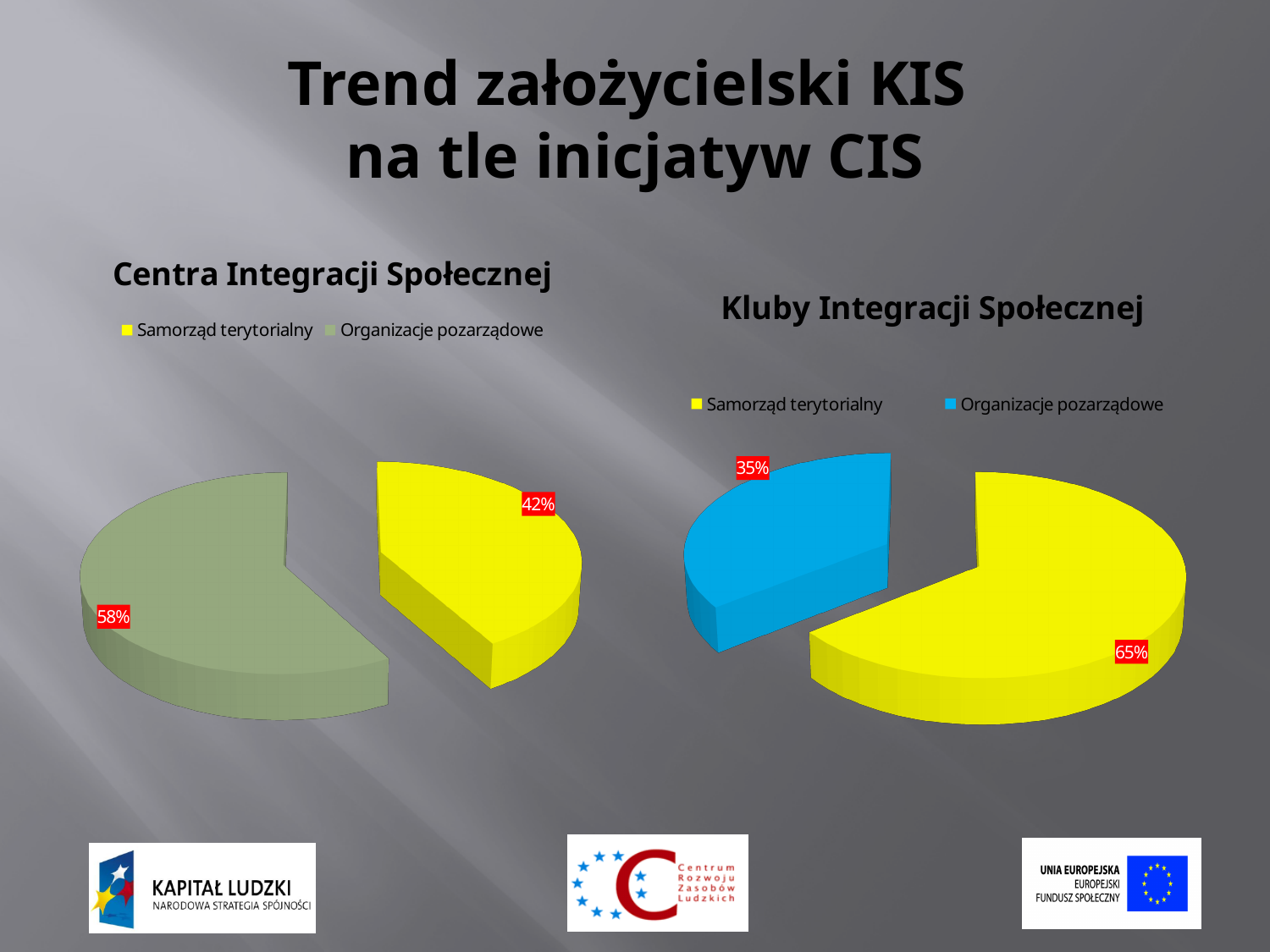
In the 'Centra Integracji Społecznej' chart, which category has the largest slice? Organizacje pozarządowe In the 'Kluby Integracji Społecznej' chart, what share does Samorząd terytorialny have? 65% What type of chart is the 'Kluby Integracji Społecznej' chart? Pie chart In the 'Kluby Integracji Społecznej' chart, which category has the smallest slice? Organizacje pozarządowe Which is larger: the Samorząd terytorialny share in the 'Centra Integracji Społecznej' chart or in the 'Kluby Integracji Społecznej' chart? Kluby Integracji Społecznej In the 'Centra Integracji Społecznej' chart, what share does Organizacje pozarządowe have? 58% In the 'Centra Integracji Społecznej' chart, what share does Samorząd terytorialny have? 42% In the 'Kluby Integracji Społecznej' chart, what share does Organizacje pozarządowe have? 35% How many slices does the 'Centra Integracji Społecznej' pie chart have? 2 In the 'Centra Integracji Społecznej' chart, what is the difference in percentage points between Organizacje pozarządowe and Samorząd terytorialny? 16 In the 'Kluby Integracji Społecznej' chart, what is the difference in percentage points between Samorząd terytorialny and Organizacje pozarządowe? 30 In the 'Kluby Integracji Społecznej' chart, what colour is the Organizacje pozarządowe slice? Blue